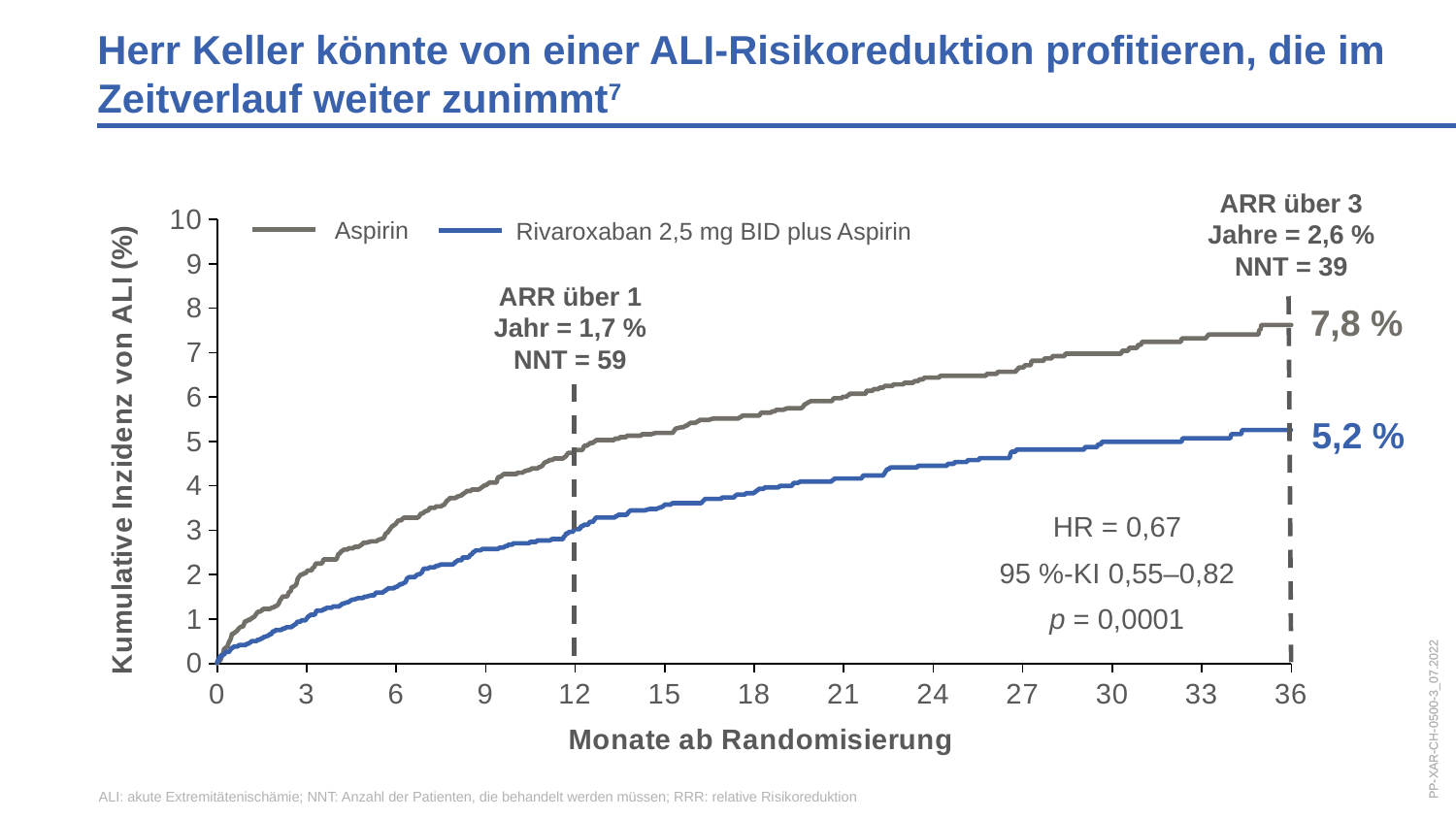
What hazard ratio (HR) is shown on the chart? 0,67 How many series does the legend list? 2 What is the difference between the Aspirin and the Rivaroxaban 2,5 mg BID plus Aspirin cumulative incidence at 36 months? 2,6 % Is the cumulative incidence for Aspirin at 12 months greater or less than 4? greater What is the label of the y axis? Kumulative Inzidenz von ALI (%) Is the cumulative incidence for Rivaroxaban 2,5 mg BID plus Aspirin at 12 months greater or less than 4? less What is the cumulative incidence of ALI for Rivaroxaban 2,5 mg BID plus Aspirin at 36 months? 5,2 % Do the cumulative incidence curves rise or fall over the months from randomisation? rise Which series has the higher cumulative incidence of ALI at 36 months? Aspirin What kind of chart is shown on the slide? line chart What is the NNT over 3 years shown on the chart? 39 What is the cumulative incidence of ALI for Aspirin at 36 months? 7,8 %